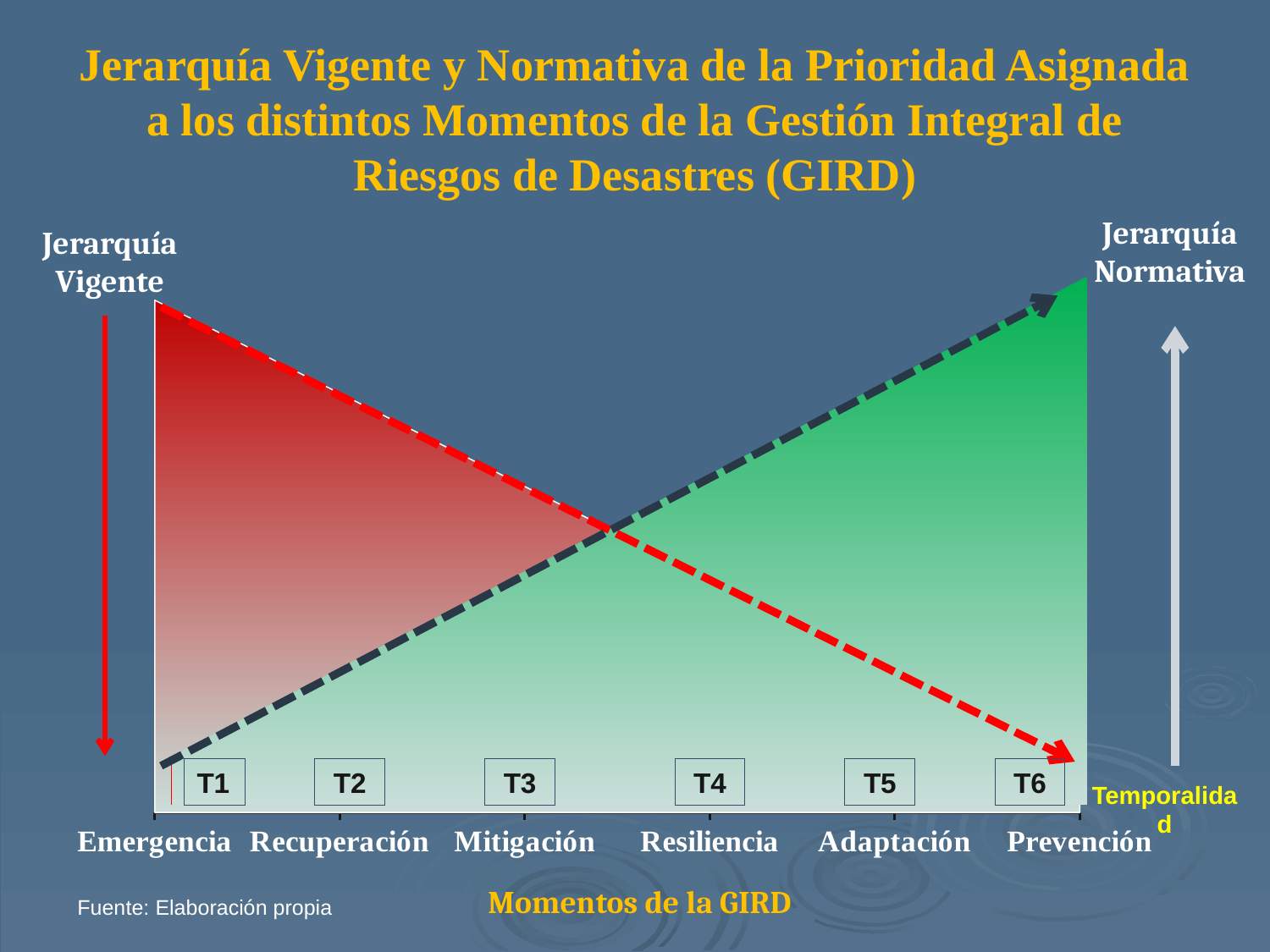
Which moment of the GIRD is labelled T6? Prevención How many moments of the GIRD are labelled along the x axis? 6 Which moment of the GIRD is labelled T4? Resiliencia What colour is the shaded area representing the Jerarquía Vigente? red At which moment is the Jerarquía Normativa highest? Prevención Which has the higher Jerarquía Normativa, Recuperación or Adaptación? Adaptación What is the title of the x axis? Momentos de la GIRD Does the dark dashed line for Jerarquía Normativa rise or fall from Emergencia to Prevención? rise Which moment of the GIRD is labelled T1? Emergencia At which moment is the Jerarquía Vigente lowest? Prevención Does the red dashed line for Jerarquía Vigente rise or fall from Emergencia to Prevención? fall At which moment is the Jerarquía Vigente highest? Emergencia